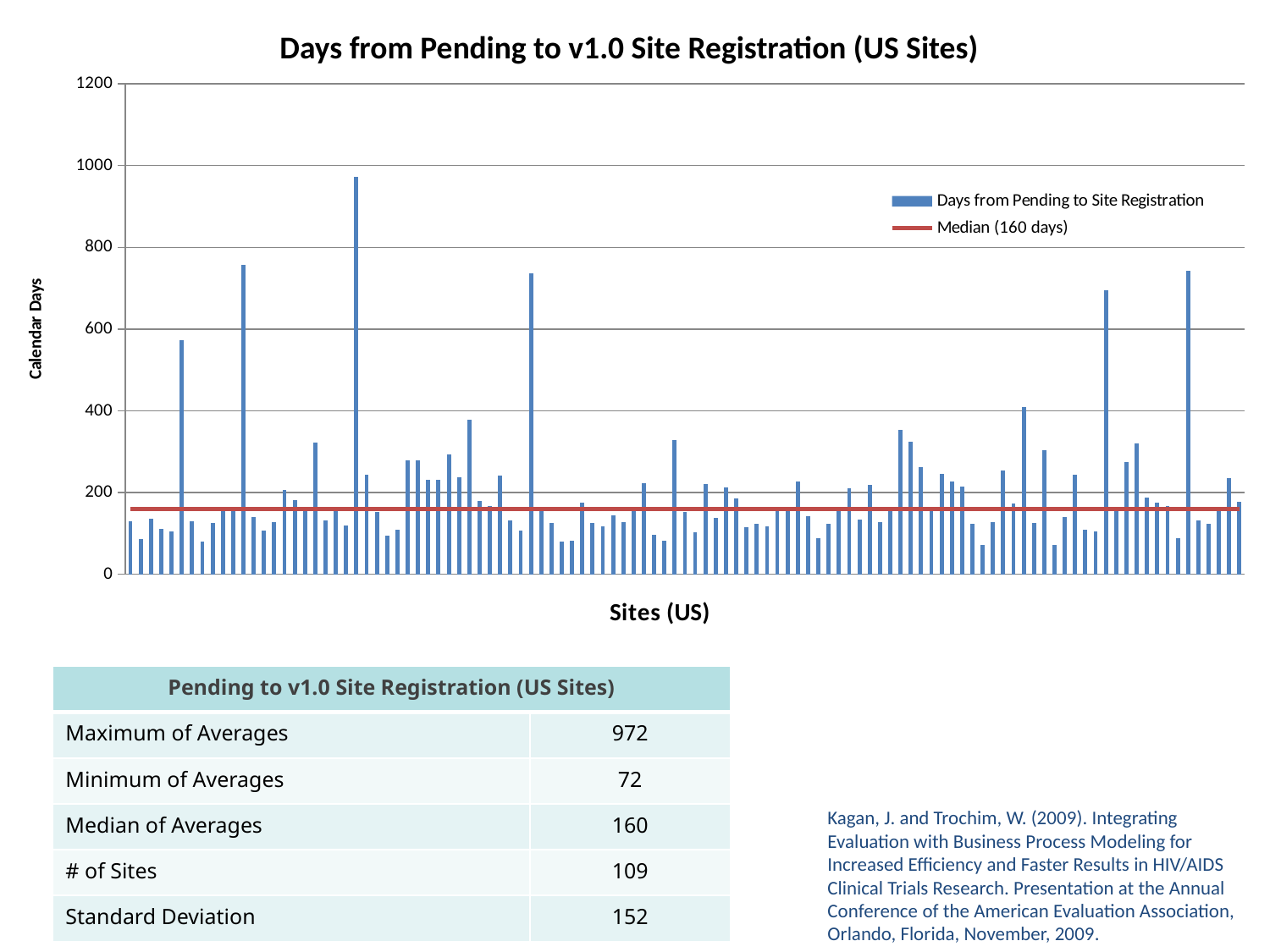
What is the title of the chart? Days from Pending to v1.0 Site Registration (US Sites) What is the difference between the maximum and minimum of averages shown in the table? 900 What value does the red horizontal line in the chart represent, according to the legend? Median (160 days) What kind of chart is shown on the slide? bar chart How many US sites are plotted in the chart, according to the table on the slide? 109 Is the tallest bar in the chart greater or less than 800 calendar days? greater What is the minimum value among the plotted site averages, as given in the table? 72 Is the median line in the chart greater or less than 200 calendar days? less What is the label of the vertical axis of the chart? Calendar Days What is the highest tick value shown on the vertical axis of the chart? 1200 What is the maximum value among the plotted site averages, as given in the table? 972 How many entries does the chart legend list? 2